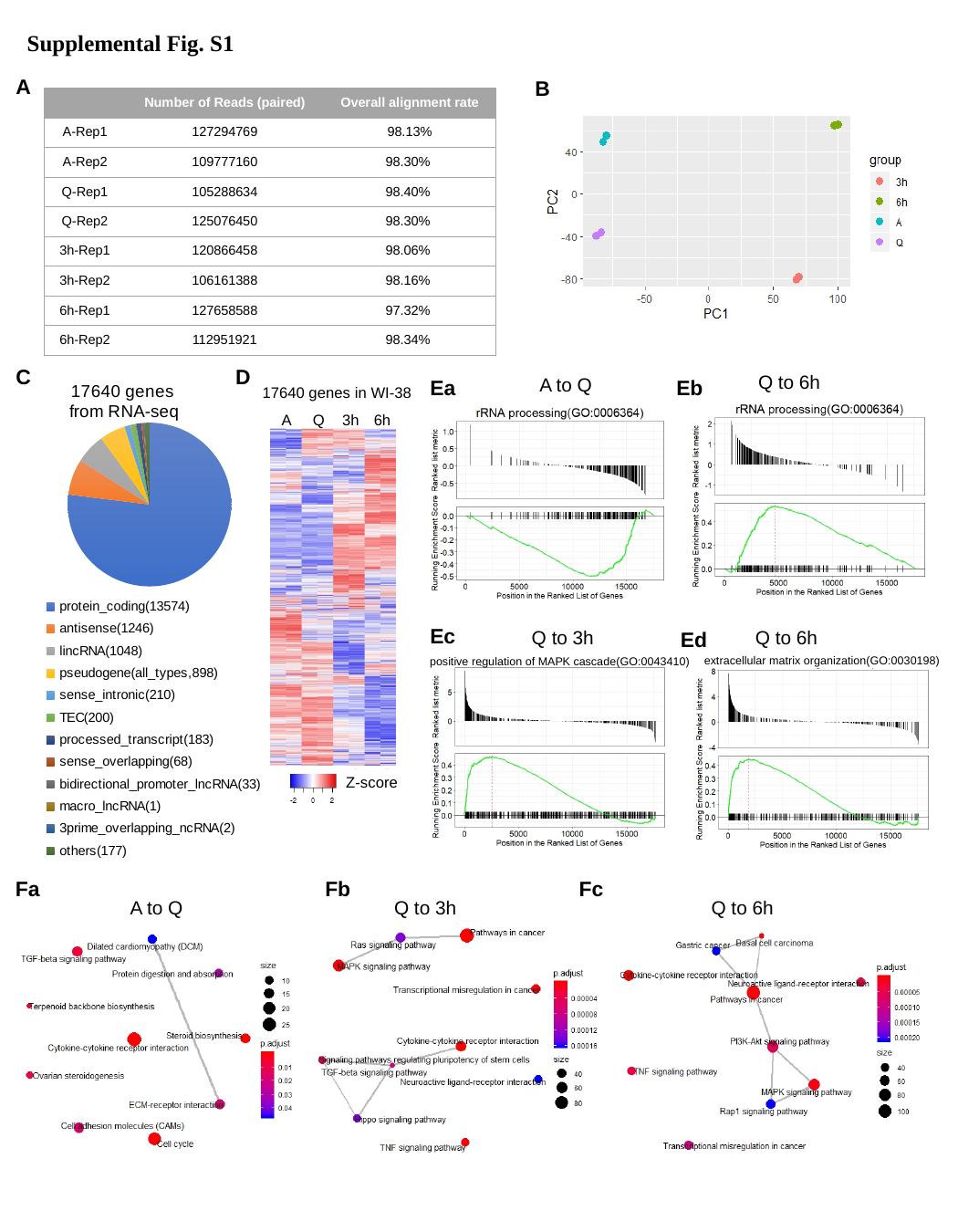
What kind of chart is panel C, '17640 genes from RNA-seq'? pie chart What gene set is shown in the GSEA plot in panel Ed? extracellular matrix organization(GO:0030198) In the pie chart in panel C, what is the difference between the antisense and lincRNA gene counts? 198 How many groups does the legend of the PCA plot in panel B list? 4 In the pie chart in panel C, which category has the largest number of genes? protein_coding How many categories does the legend of the pie chart in panel C list? 12 In the table in panel A, which sample has the lowest overall alignment rate? 6h-Rep1 In the pie chart in panel C, which category has the smallest number of genes? macro_lncRNA In the PCA plot in panel B, is the PC1 value of the 6h group greater or less than 50? greater In the pie chart in panel C, which has more genes: pseudogene(all_types) or sense_intronic? pseudogene(all_types) In the pie chart in panel C, how many genes are protein_coding according to the legend? 13574 In the PCA plot in panel B, is the PC2 value of the 3h group greater or less than -40? less